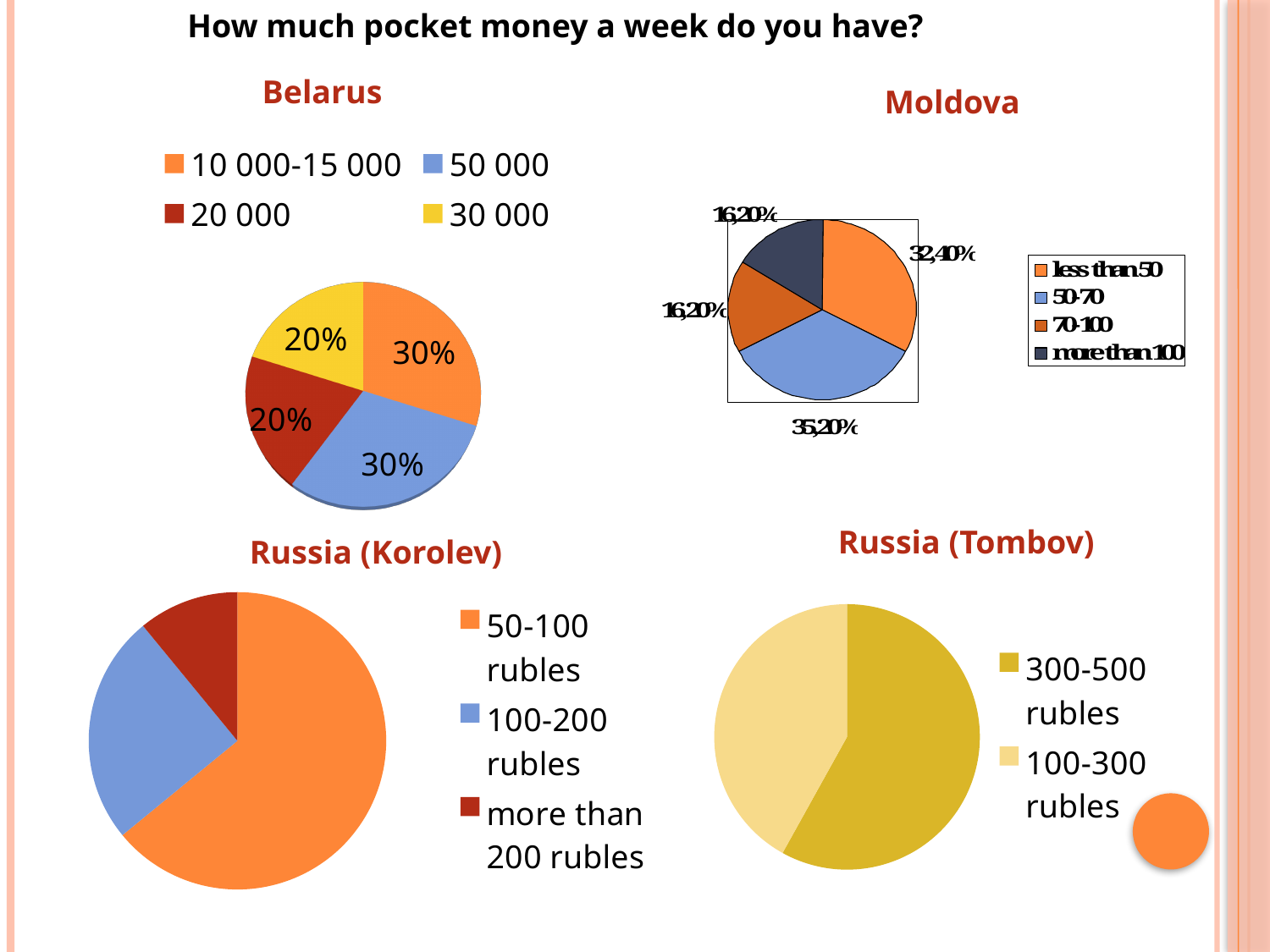
In the Belarus chart, what is the difference between the 50 000 share and the 30 000 share? 10% In the Moldova chart, which category has the largest share? 50-70 In the Russia (Tombov) chart, which slice is larger: 300-500 rubles or 100-300 rubles? 300-500 rubles What type of chart is used for the Belarus data? Pie chart In the Russia (Korolev) chart, which category has the largest slice? 50-100 rubles In the Russia (Korolev) chart, which category has the smallest slice? more than 200 rubles In the Belarus chart, what percentage is shown for the 20 000 category? 20% In the Moldova chart, what percentage is shown for the less than 50 category? 32,40% How many categories does the Russia (Korolev) chart's legend list? 3 In the Moldova chart, what is the difference between the 50-70 share and the less than 50 share? 2,80% In the Moldova chart, what percentage is shown for the 50-70 category? 35,20% In the Belarus chart, what share of respondents have 10 000-15 000 pocket money a week? 30%